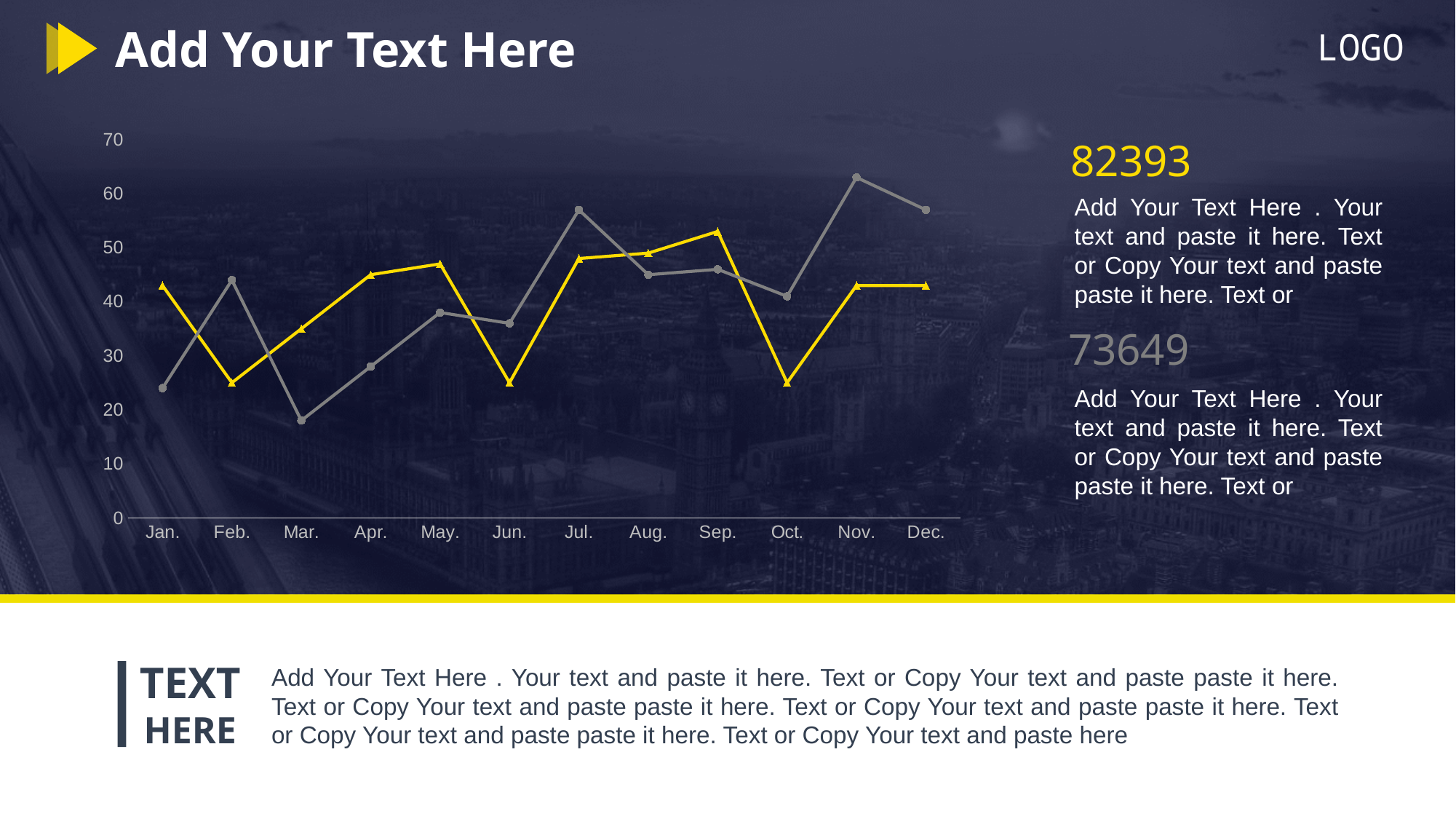
In which month does the yellow line reach its highest value? Sep. Is the value of the yellow line in Jun. greater or less than 30? less What kind of chart is shown on the slide? line chart Is the value of the gray line in Mar. greater or less than 20? less In Feb., which line has the higher value, the yellow line or the gray line? gray line How many months are shown on the x axis of the chart? 12 Is the value of the yellow line in Sep. greater or less than 50? greater How many lines (series) are plotted on the chart? 2 In Jan., which line has the higher value, the yellow line or the gray line? yellow line In which month does the gray line reach its highest value? Nov. In which month does the gray line reach its lowest value? Mar.